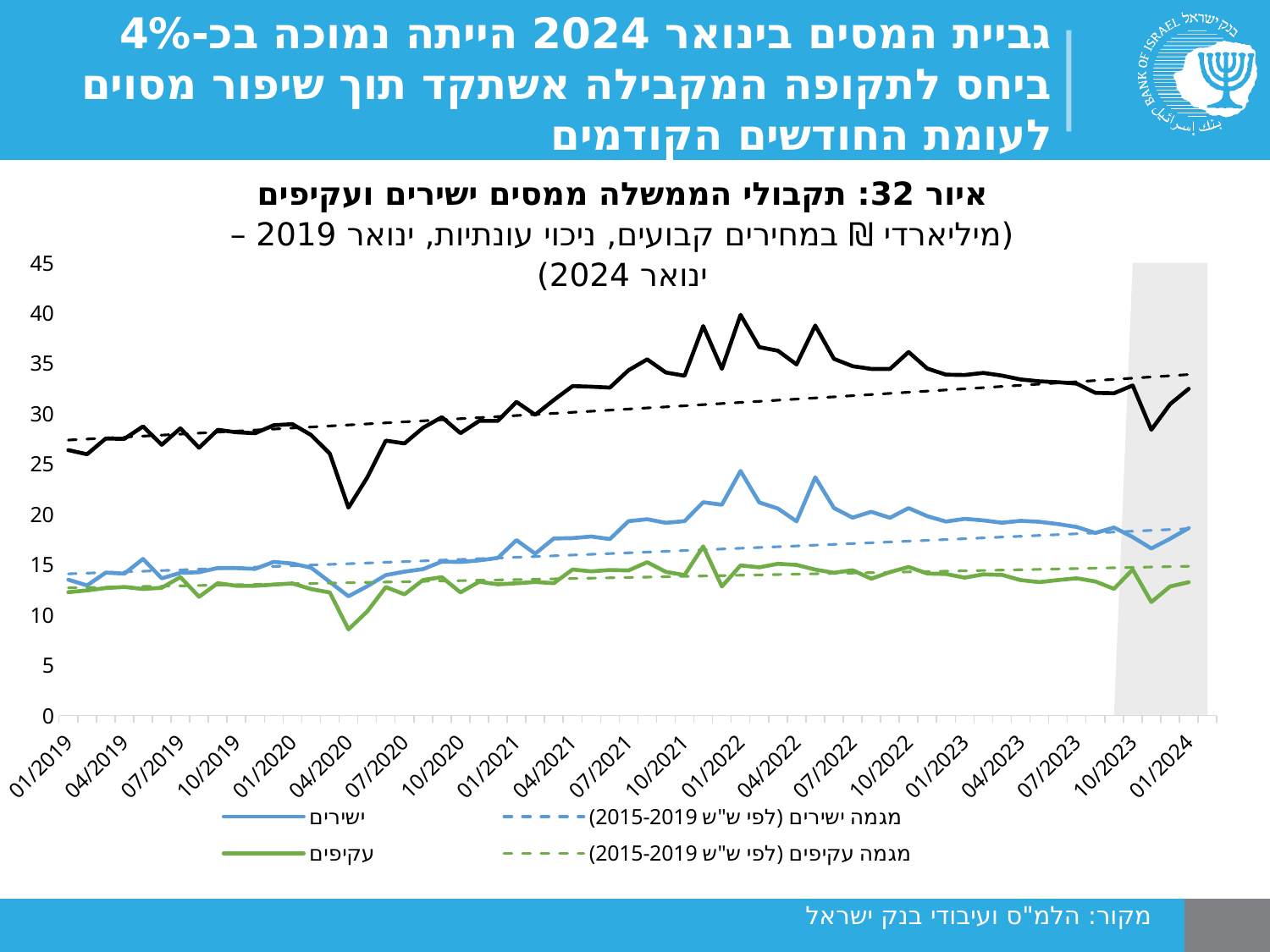
Is the value of the עקיפים (green solid) line at 04/2020 greater or less than 10? less How many series does the legend list? 4 What kind of chart is shown on the slide? line chart Is the value of the black line at 04/2020 greater or less than 25? less Is the value of the ישירים (blue solid) line at 01/2019 greater or less than 15? less Which series is drawn with a solid blue line according to the legend? ישירים What is the figure number given in the chart title? 32 What is the highest value shown on the y axis? 45 Does the dashed blue trend line (מגמה ישירים) rise or fall from 01/2019 to 01/2024? rise At 01/2024, which solid line is higher: ישירים (blue) or עקיפים (green)? ישירים